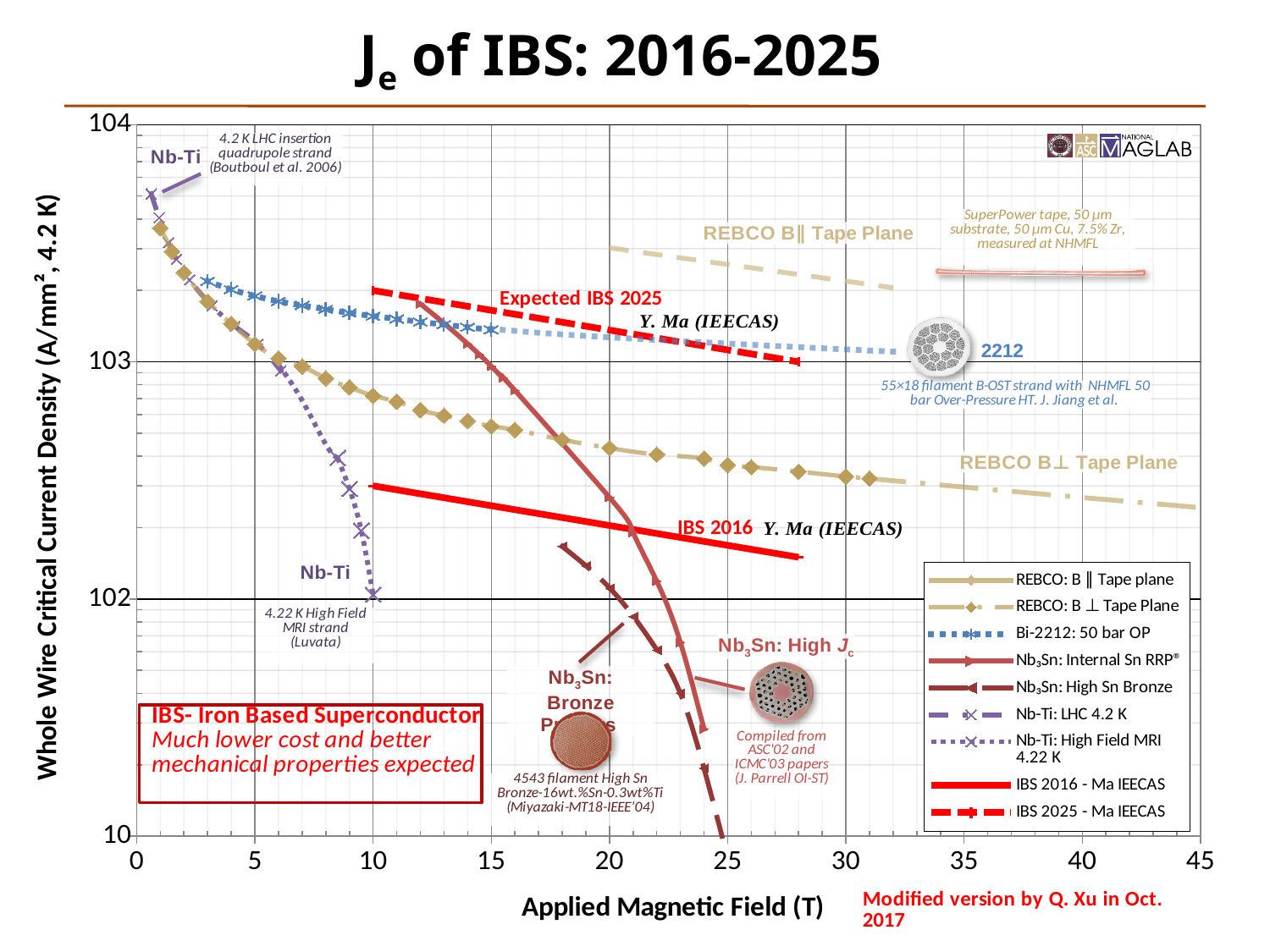
Which series has the lowest critical current density at 30 T? REBCO B ⊥ Tape Plane Does the Nb-Ti: High Field MRI 4.22 K curve rise or fall as the applied magnetic field increases? fall What is the label of the x axis? Applied Magnetic Field (T) How many series does the legend list? 9 What is the title of the slide's chart? Je of IBS: 2016-2025 At 20 T, which is higher: Nb3Sn: Internal Sn RRP or Nb3Sn: High Sn Bronze? Nb3Sn: Internal Sn RRP At 20 T, which is higher: REBCO B ∥ Tape plane or REBCO B ⊥ Tape Plane? REBCO B ∥ Tape plane Which series has the highest critical current density at 30 T? REBCO B ∥ Tape plane What kind of chart is shown on the slide? line chart How many tick labels are shown on the x axis? 10 At 20 T, which is higher: the IBS 2025 - Ma IEECAS line or the IBS 2016 - Ma IEECAS line? IBS 2025 - Ma IEECAS Does the IBS 2016 - Ma IEECAS line rise or fall as the applied magnetic field increases? fall